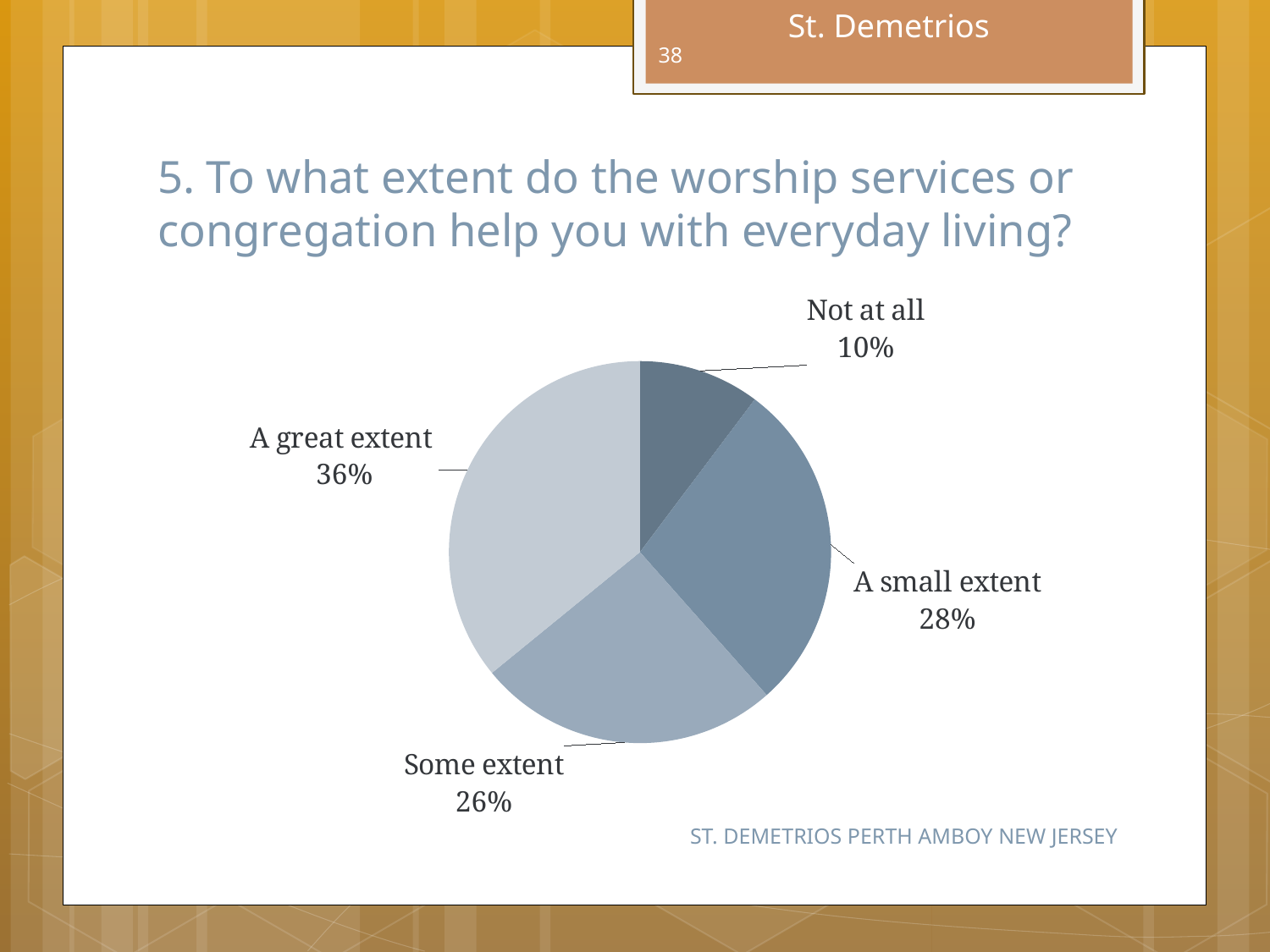
Which response category has the smallest share of the pie? Not at all Which response category has the largest share of the pie? A great extent What percentage of respondents answered "A small extent"? 28% What percentage of respondents answered "A great extent"? 36% Which is larger, the share for "A small extent" or the share for "Some extent"? A small extent What is the difference in percentage points between "A great extent" and "Not at all"? 26 What is the combined share of "A great extent" and "Some extent"? 62% What percentage of respondents answered "Some extent"? 26% What percentage of respondents answered "Not at all"? 10% What question does the chart on the slide present results for? To what extent do the worship services or congregation help you with everyday living? How many response categories are shown in the pie chart? 4 What kind of chart is shown on the slide? Pie chart